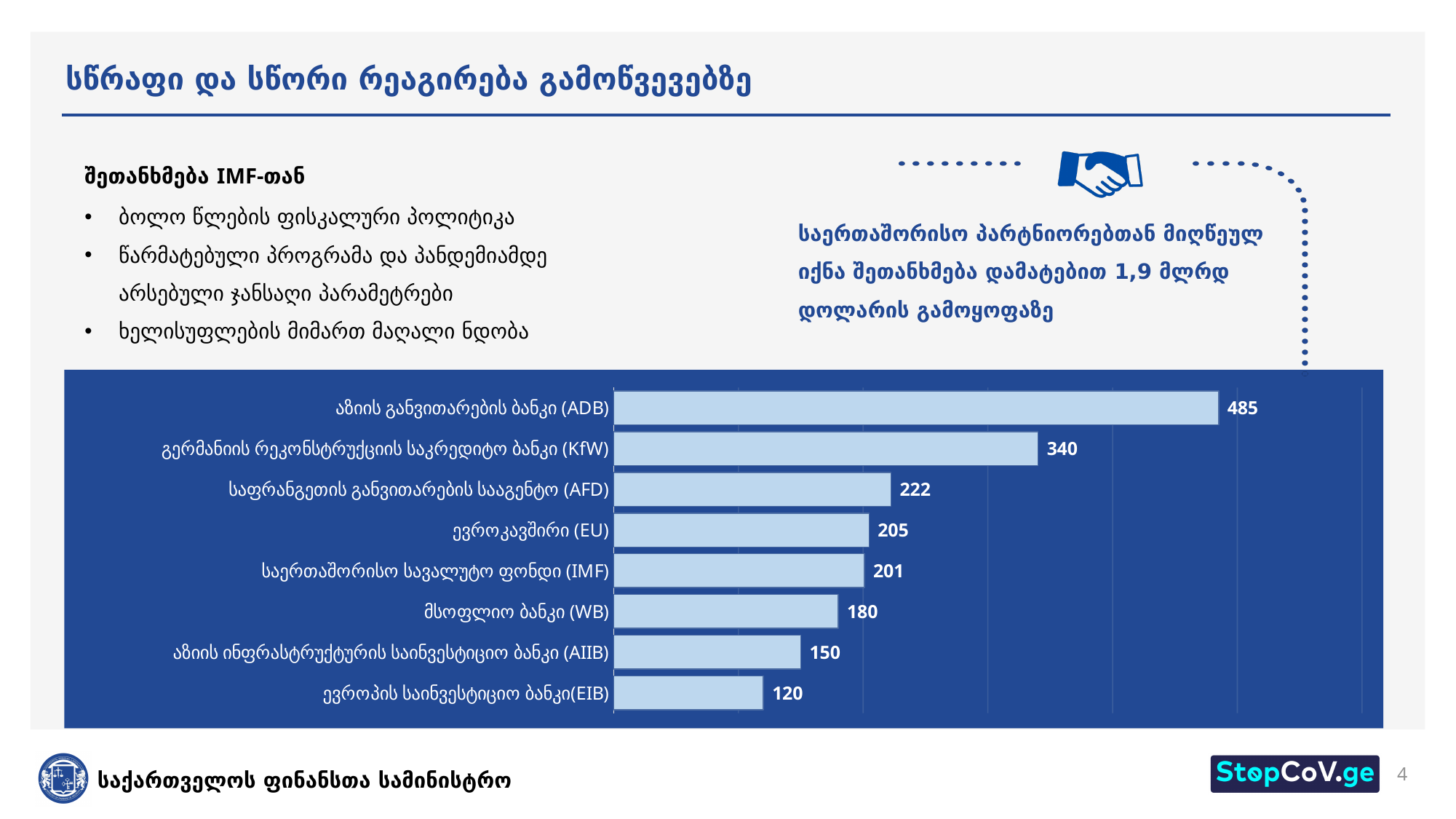
How many categories (bars) are shown in the chart? 8 What is the value for the Asian Development Bank (ADB) bar? 485 What is the value shown for the European Investment Bank (EIB)? 120 What kind of chart is shown on the slide? Bar chart Which category has the highest value in the chart? ADB What is the value shown for the European Union (EU)? 205 What is the value shown for the World Bank (WB)? 180 Do the bar values increase or decrease from the top of the chart to the bottom? Decrease Which is larger, the value for AIIB or the value for WB? WB What is the difference between the values for AFD and IMF? 21 Which category has the lowest value in the chart? EIB What is the difference between the values for ADB and KfW? 145